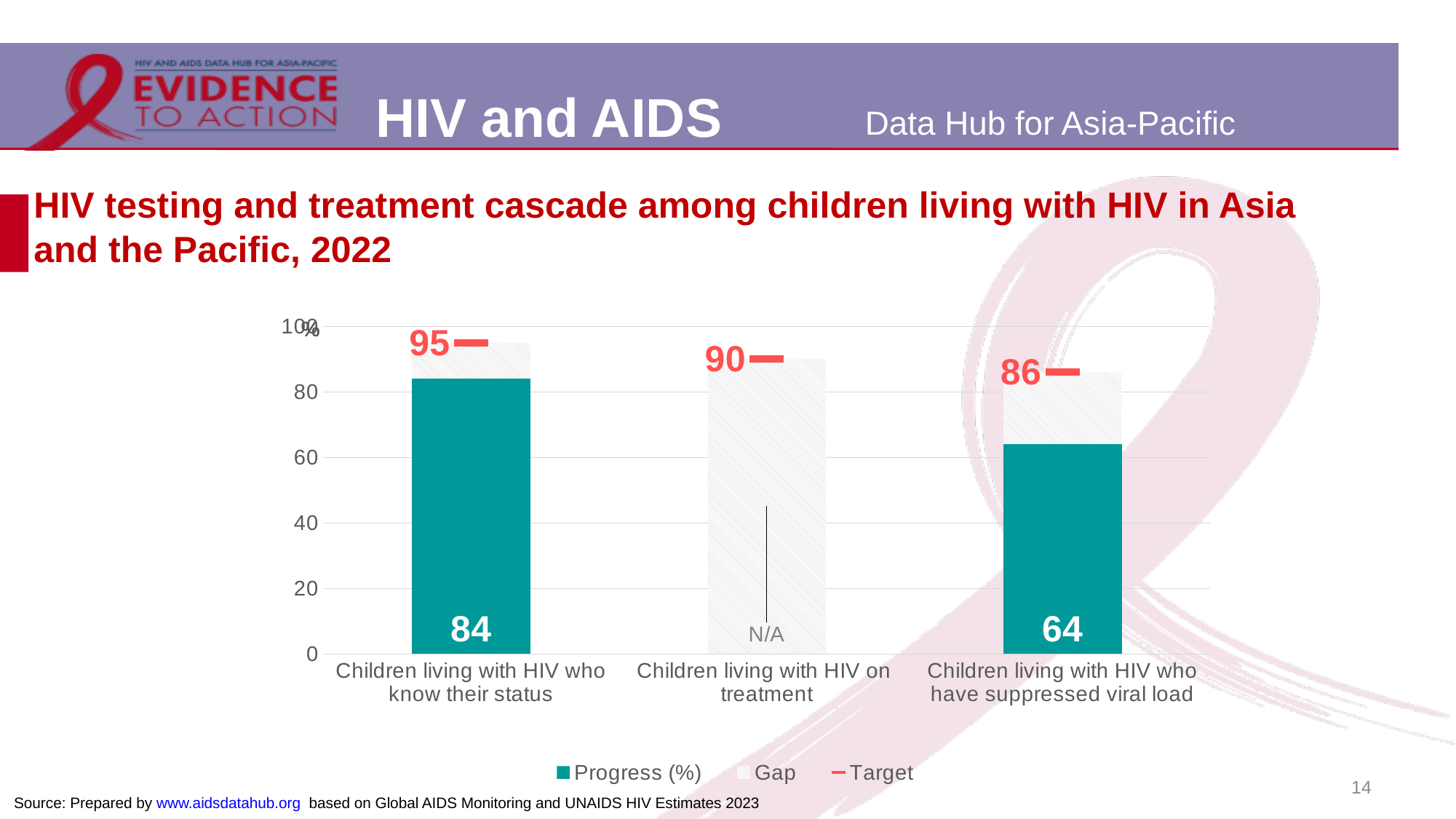
What is the target value shown for children living with HIV on treatment? 90 What is the difference between the target and the progress value for children living with HIV who have suppressed viral load? 22 How many categories are shown on the x axis of the chart? 3 What progress value is shown for children living with HIV on treatment? N/A How many series does the chart legend list? 3 Which has the higher progress value: children living with HIV who know their status or children living with HIV who have suppressed viral load? Children living with HIV who know their status What is the target value shown for children living with HIV who know their status? 95 What type of chart is shown on the slide? Bar chart What is the difference between the target and the progress value for children living with HIV who know their status? 11 What is the progress value for children living with HIV who have suppressed viral load? 64 What is the progress value for children living with HIV who know their status? 84 What is the target value shown for children living with HIV who have suppressed viral load? 86